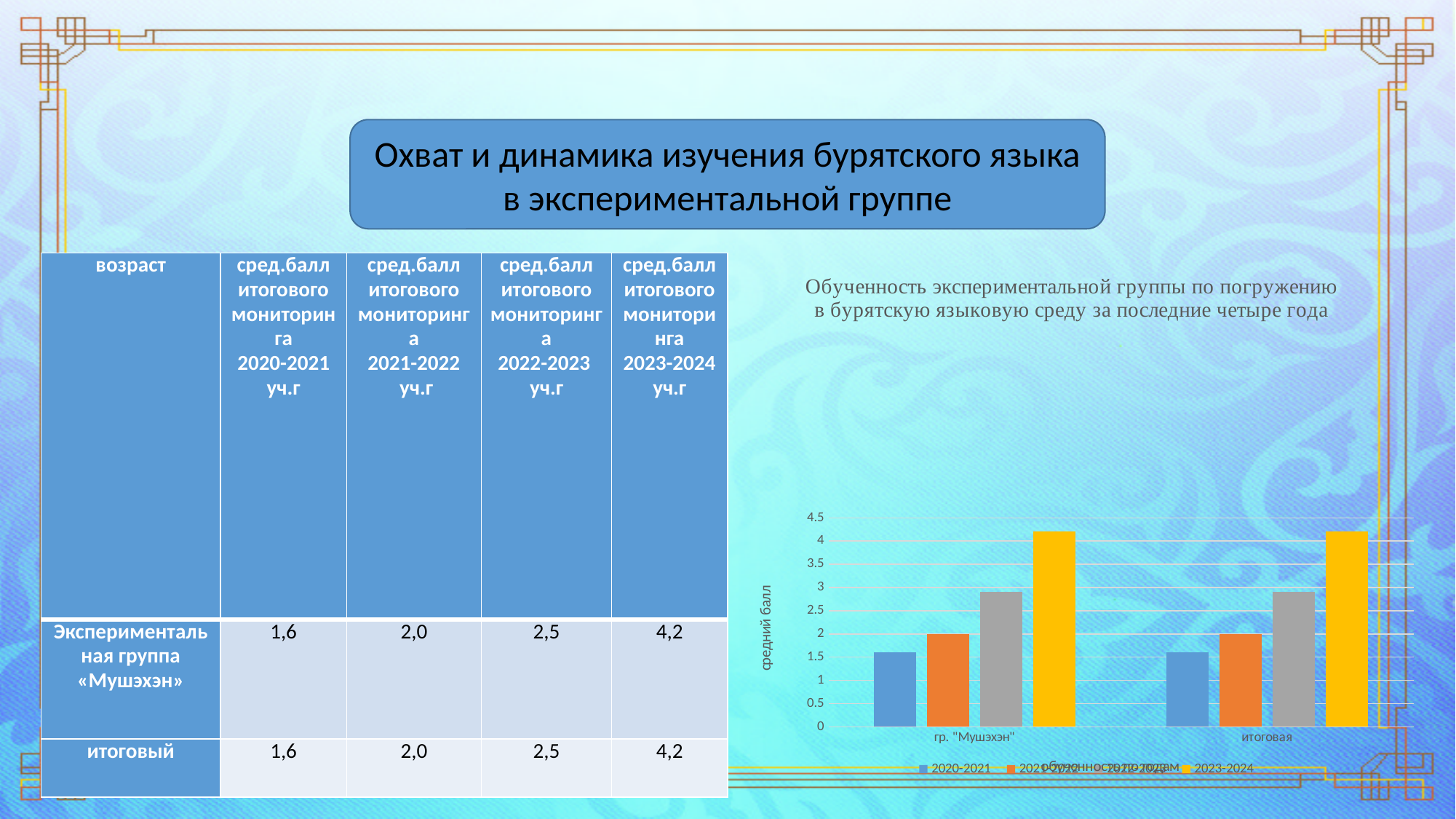
In the bar chart, what is the value of the 2021-2022 series for гр. "Мушэхэн"? 2 In the bar chart, which series has the shortest bar for the category итоговая? 2020-2021 In the bar chart, is the value of the 2020-2021 series for гр. "Мушэхэн" greater or less than 2? less What is the label of the vertical axis of the bar chart? средний балл In the bar chart, which series has the tallest bar for the category гр. "Мушэхэн"? 2023-2024 In the bar chart, is the value of the 2023-2024 series for итоговая greater or less than 4? greater How many categories are shown on the x axis of the bar chart? 2 How many series does the legend of the bar chart list? 4 In the bar chart, which is larger for гр. "Мушэхэн": the 2022-2023 bar or the 2023-2024 bar? 2023-2024 What kind of chart is shown on the right side of the slide? bar chart In the bar chart, do the values rise or fall from the 2020-2021 series to the 2023-2024 series within each category? rise